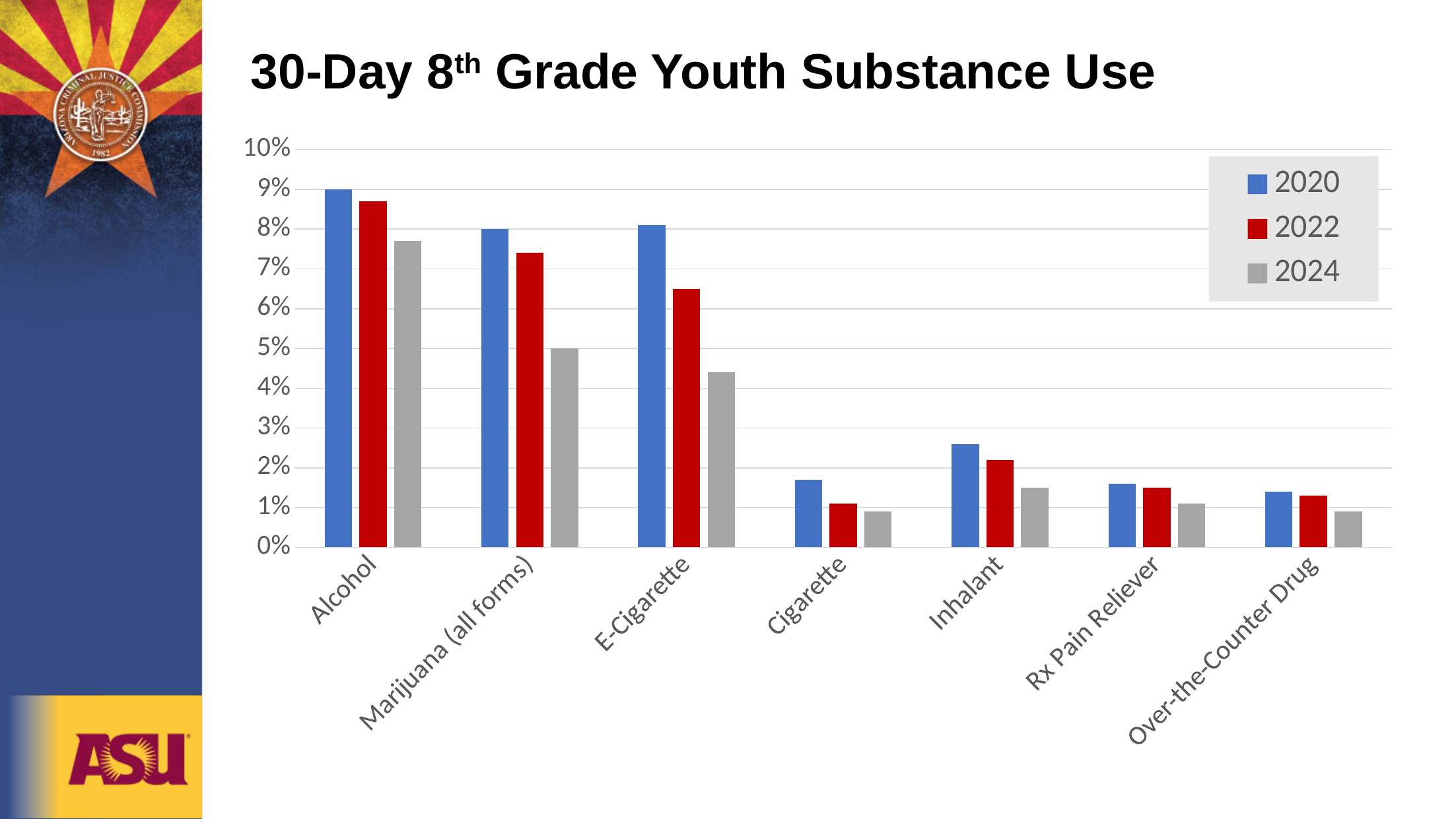
What is the 2024 value for Marijuana (all forms)? 5% Is the 2024 value for Alcohol greater or less than 7%? greater What is the 2020 value for Marijuana (all forms)? 8% How many substance categories are shown on the x axis? 7 Is the 2020 value for Inhalant greater or less than 2%? greater What kind of chart is shown on the slide? bar chart How many series does the legend list? 3 Which substance has the highest 2020 value? Alcohol What colour represents the 2024 series in the legend? grey For Alcohol, do the values rise or fall from 2020 to 2024? fall Which is larger, the 2020 value for Alcohol or the 2020 value for E-Cigarette? Alcohol Is the 2024 value for E-Cigarette greater or less than 5%? less